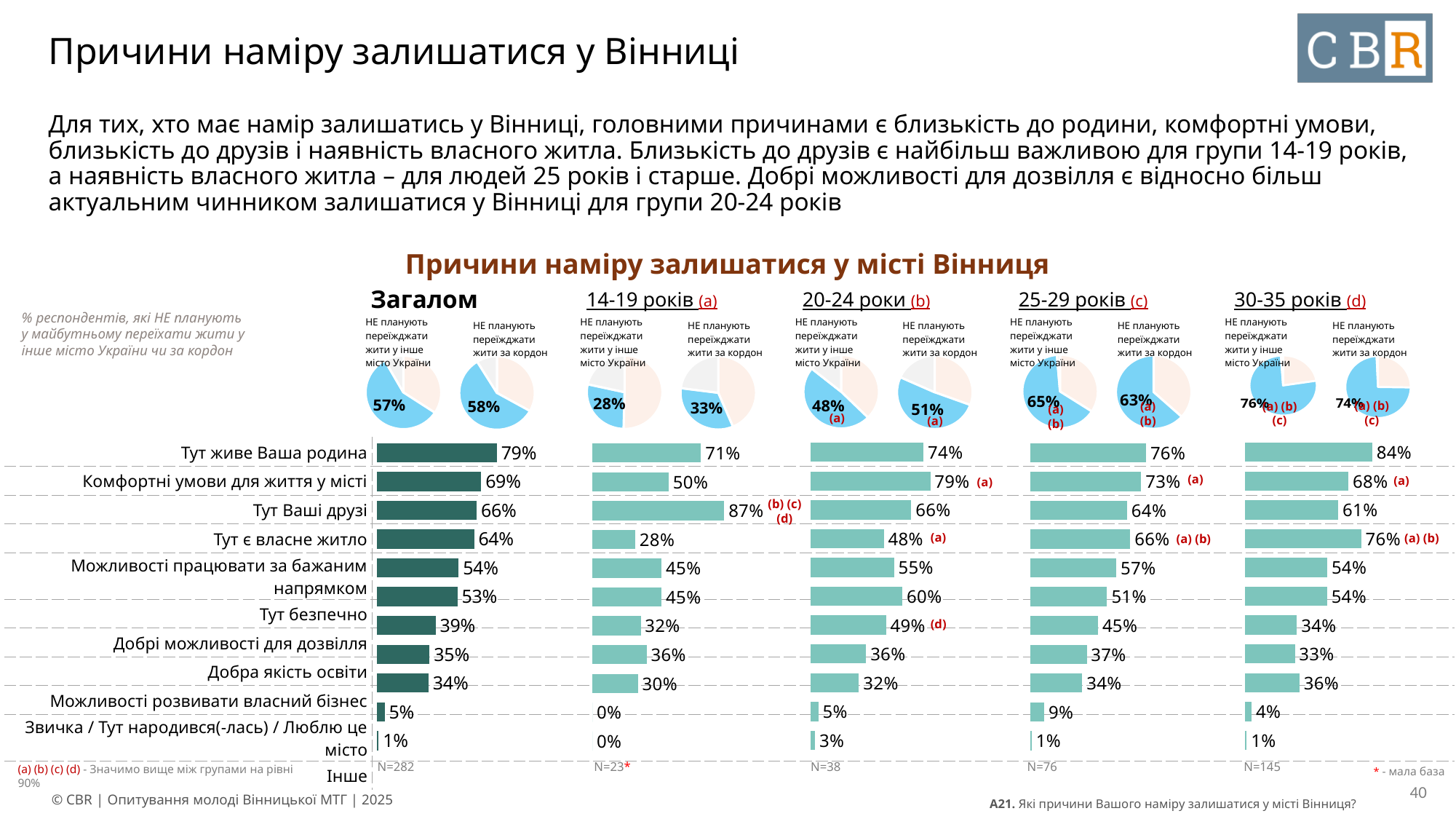
In the 'Загалом' bar chart, which category has the highest value? Тут живе Ваша родина In the 'Загалом' bar chart, what is the value for 'Тут живе Ваша родина'? 79% In the '30-35 років' pie chart for 'НЕ планують переїжджати жити у інше місто України', what share is shown? 76% In the '14-19 років' bar chart, which is larger: 'Тут живе Ваша родина' or 'Тут Ваші друзі'? Тут Ваші друзі Which age group has the larger share of respondents who do not plan to move to another city of Ukraine: '14-19 років' or '25-29 років'? 25-29 років In the '25-29 років' bar chart, what is the value for 'Комфортні умови для життя у місті'? 73% In the 'Загалом' pie chart for 'НЕ планують переїжджати жити за кордон', what share is shown? 58% What is the sample size (N) shown under the 'Загалом' bar chart? N=282 In the '14-19 років' bar chart, what is the value for 'Тут Ваші друзі'? 87% In the '30-35 років' bar chart, what is the value for 'Тут є власне житло'? 76% In the '30-35 років' bar chart, what is the difference between 'Тут живе Ваша родина' and 'Тут є власне житло'? 8 percentage points What type of chart is used to show the reasons for staying in Vinnytsia by age group? Bar chart